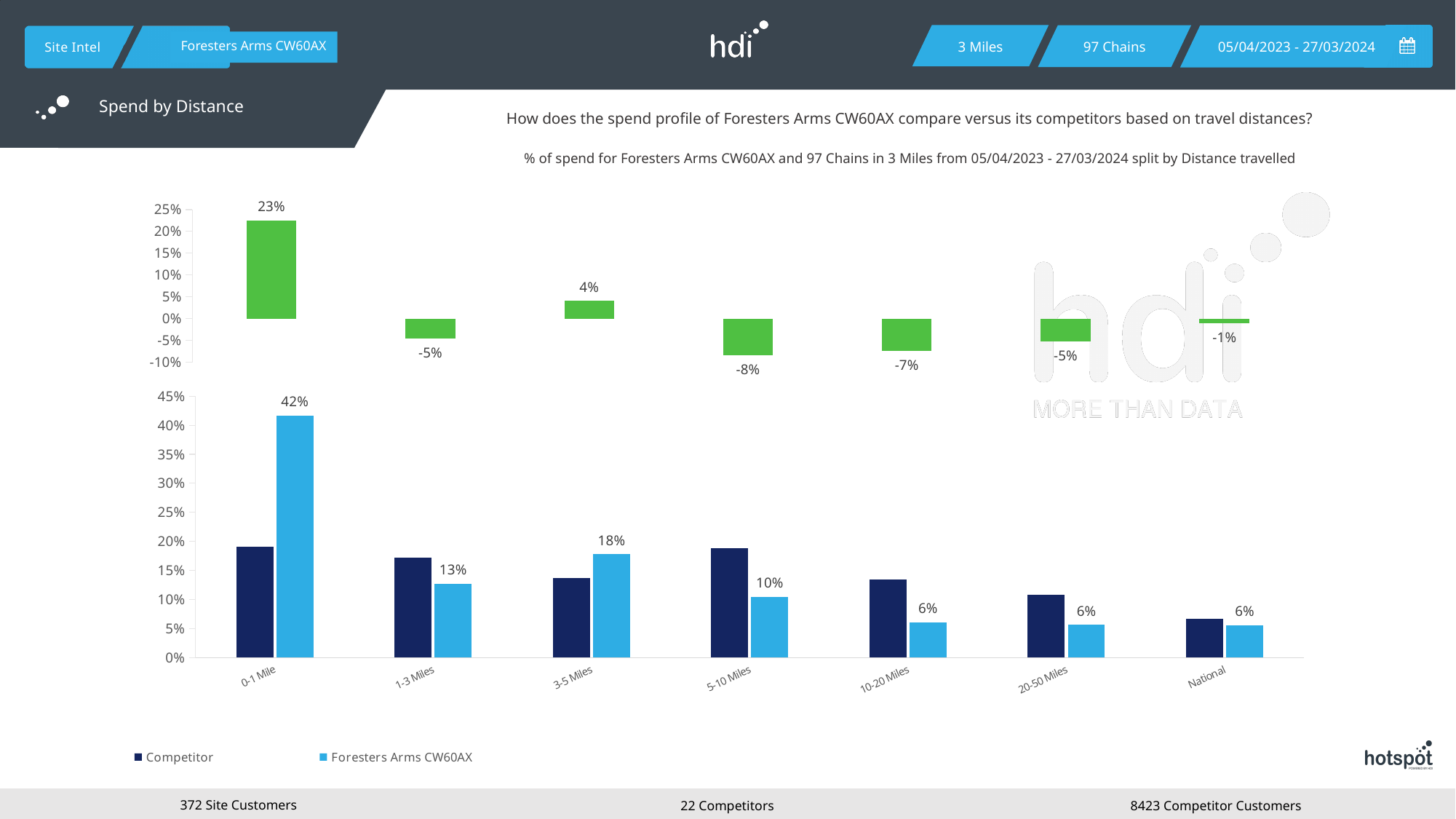
In the top chart, what is the value shown for the 5-10 Miles category? -8% In the bottom chart, what is the value for Foresters Arms CW60AX in the 3-5 Miles category? 18% In the top chart, which category has the lowest value? 5-10 Miles In the bottom chart, what is the difference between the Foresters Arms CW60AX values for 0-1 Mile and 1-3 Miles? 29% In the bottom chart, which is larger in the 5-10 Miles category: the Competitor bar or the Foresters Arms CW60AX bar? Competitor In the bottom chart, is the Competitor value for 0-1 Mile greater or less than 15%? greater How many series does the legend of the bottom chart list? 2 What type of chart is the bottom chart? Bar chart How many categories are shown on the x axis of the bottom chart? 7 In the bottom chart, which category has the highest value for Foresters Arms CW60AX? 0-1 Mile In the top chart, what is the value shown for the 0-1 Mile category? 23% In the bottom chart, what is the value for Foresters Arms CW60AX in the 0-1 Mile category? 42%